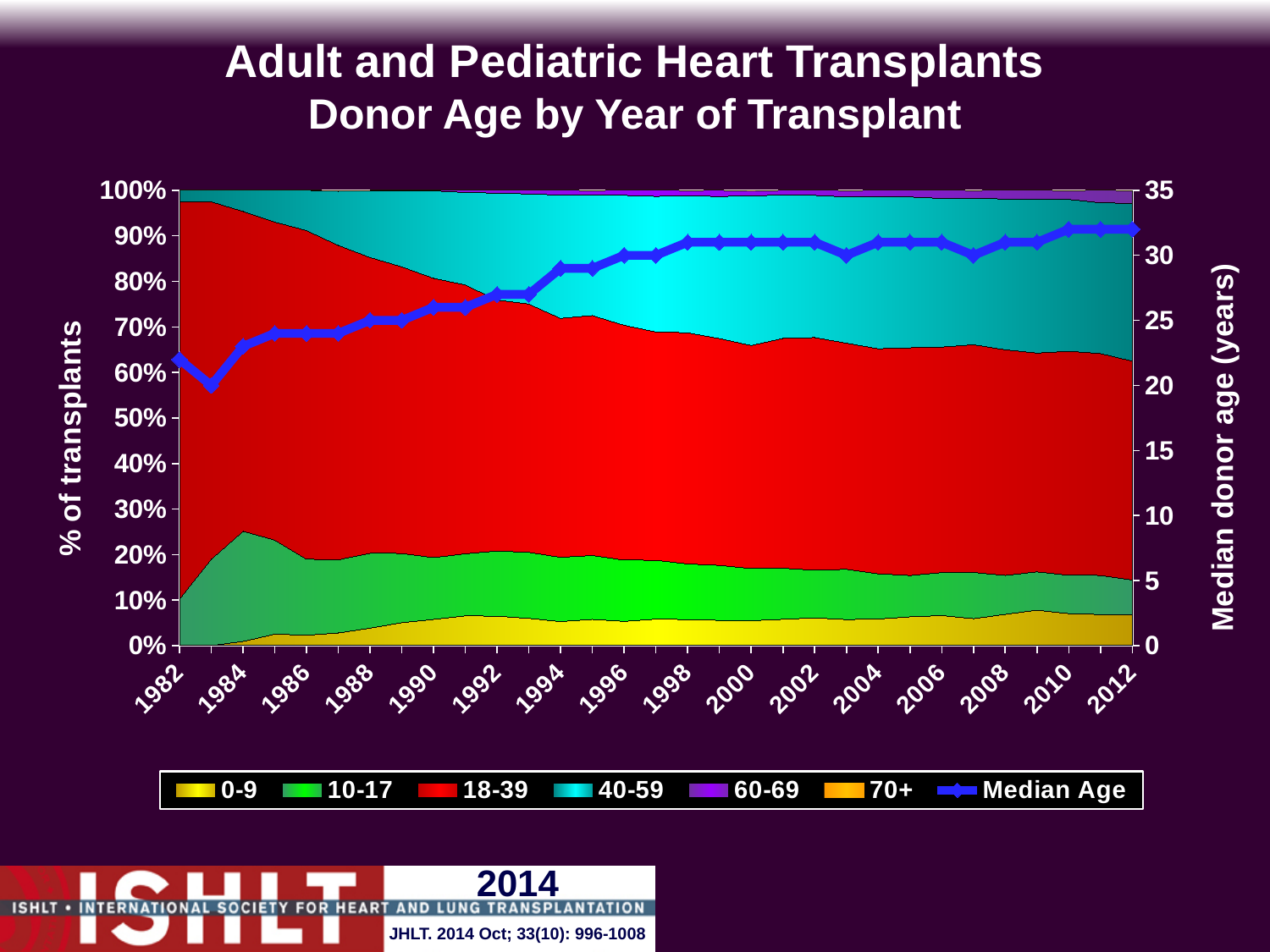
How many year labels are shown on the x axis? 16 Is the median donor age in 2012 greater or less than 30 years? greater In 2012, which has the larger share of transplants: donors aged 18-39 or donors aged 40-59? 18-39 How many series does the legend list? 7 Does the share of transplants from 40-59 year old donors rise or fall from 1982 to 2012? Rises What is the label of the right-hand vertical axis? Median donor age (years) Is the median donor age in 1982 greater or less than 25 years? less Does the share of transplants from 18-39 year old donors rise or fall from 1982 to 2012? Falls What kind of chart is shown on the slide? Stacked area chart with a line Does the Median Age line rise or fall from 1982 to 2012? Rises Which donor age group accounts for the largest share of transplants in 1982? 18-39 Is the median donor age in 1990 greater or less than 30 years? less